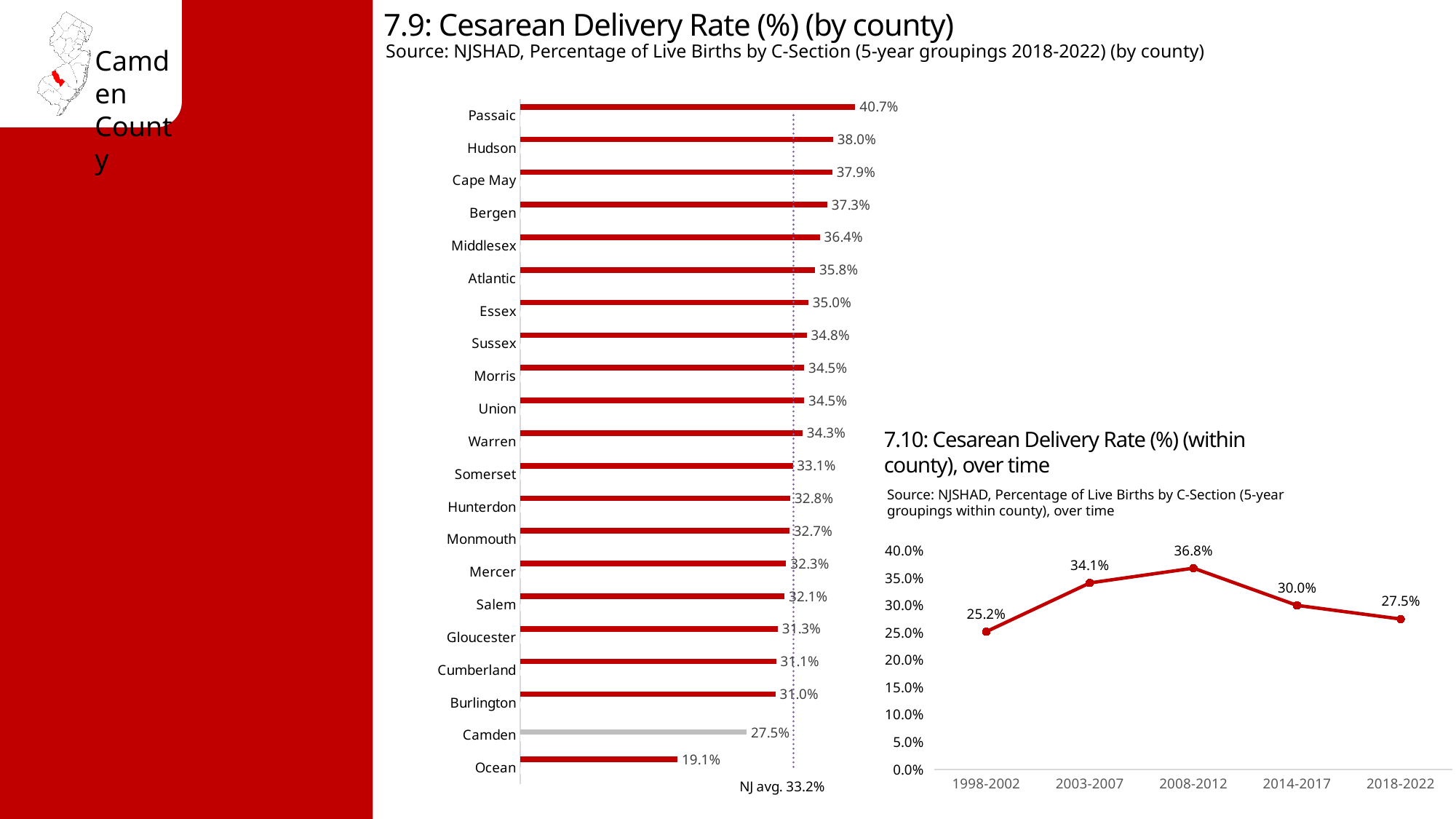
In chart 7.10 (Cesarean Delivery Rate within county, over time), which period has the lowest value? 1998-2002 In chart 7.9 (Cesarean Delivery Rate by county), what is the NJ average shown? 33.2% In chart 7.9 (Cesarean Delivery Rate by county), what is the difference between Passaic and Ocean? 21.6% In chart 7.9 (Cesarean Delivery Rate by county), what is the value for Hudson? 38.0% In chart 7.10 (Cesarean Delivery Rate within county, over time), what is the difference between 2008-2012 and 2018-2022? 9.3% In chart 7.9 (Cesarean Delivery Rate by county), which county has the highest rate? Passaic What kind of chart is 7.10 (Cesarean Delivery Rate within county, over time)? Line chart In chart 7.9 (Cesarean Delivery Rate by county), which county has the lowest rate? Ocean In chart 7.9 (Cesarean Delivery Rate by county), how many counties are shown? 21 In chart 7.10 (Cesarean Delivery Rate within county, over time), what is the value for 2008-2012? 36.8% In chart 7.9 (Cesarean Delivery Rate by county), which is larger, Gloucester or Burlington? Gloucester In chart 7.9 (Cesarean Delivery Rate by county), what is the value for Camden? 27.5%